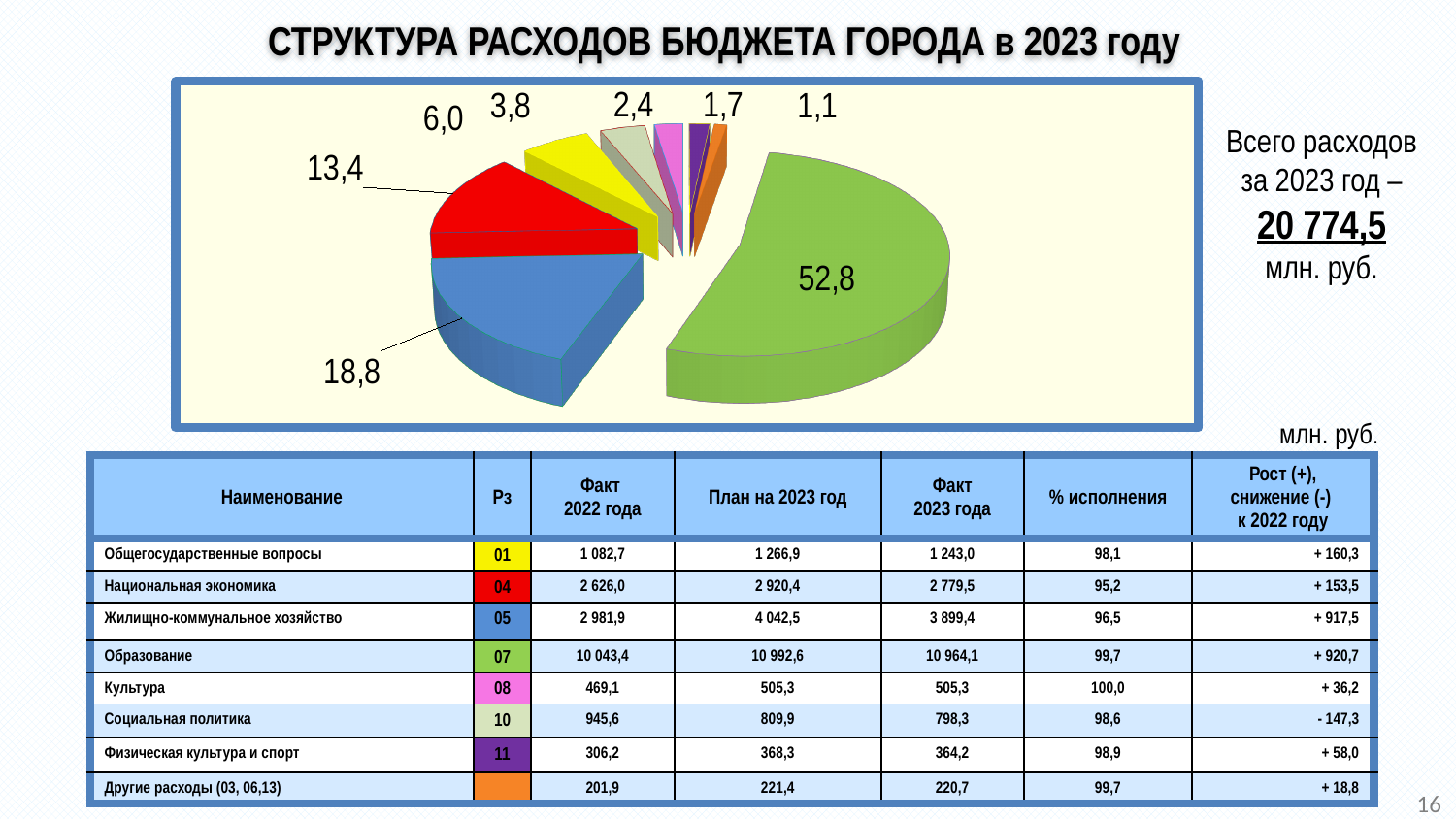
What is the value shown on the smallest slice of the pie chart? 1,1 What is the title of the slide containing the pie chart? СТРУКТУРА РАСХОДОВ БЮДЖЕТА ГОРОДА в 2023 году What is the difference between the green slice (52,8) and the blue slice (18,8) in the pie chart? 34,0 What is the value shown on the largest slice of the pie chart? 52,8 Is the value of the green slice in the pie chart greater or less than 50? greater Which slice is larger in the pie chart, the red one or the yellow one? the red one What value is labelled on the red slice of the pie chart? 13,4 Which colour is the largest slice of the pie chart? green What kind of chart is shown on the slide? pie chart What value is labelled on the yellow slice of the pie chart? 6,0 How many slices does the pie chart have? 8 What value is labelled on the blue slice of the pie chart? 18,8